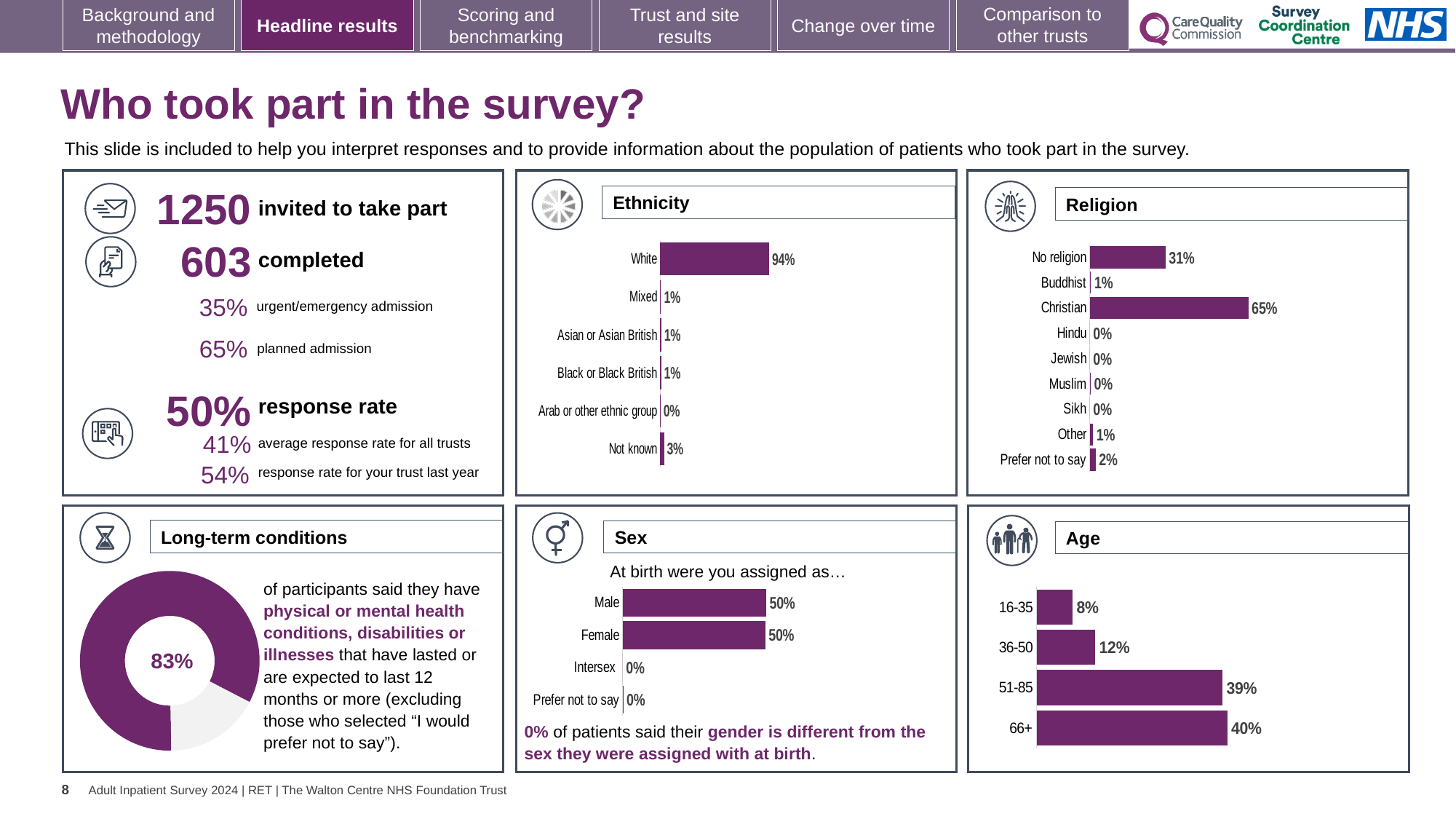
In the Long-term conditions chart, what share of participants said they have physical or mental health conditions, disabilities or illnesses? 83% In the Age chart, what is the value for 51-85? 39% In the Ethnicity chart, which category has the highest value? White In the Ethnicity chart, what percentage of respondents are White? 94% In the Sex chart, what is the value for Female? 50% In the Religion chart, what is the value for Christian? 65% In the Age chart, do the values rise or fall as you move from the youngest to the oldest age group? rise In the Religion chart, how many categories are listed? 9 In the Ethnicity chart, how many categories are shown? 6 What kind of chart is used in the Long-term conditions panel? Donut (pie) chart In the Religion chart, what is the difference between the Christian and No religion values? 34% In the Age chart, which age group has the lowest value? 16-35